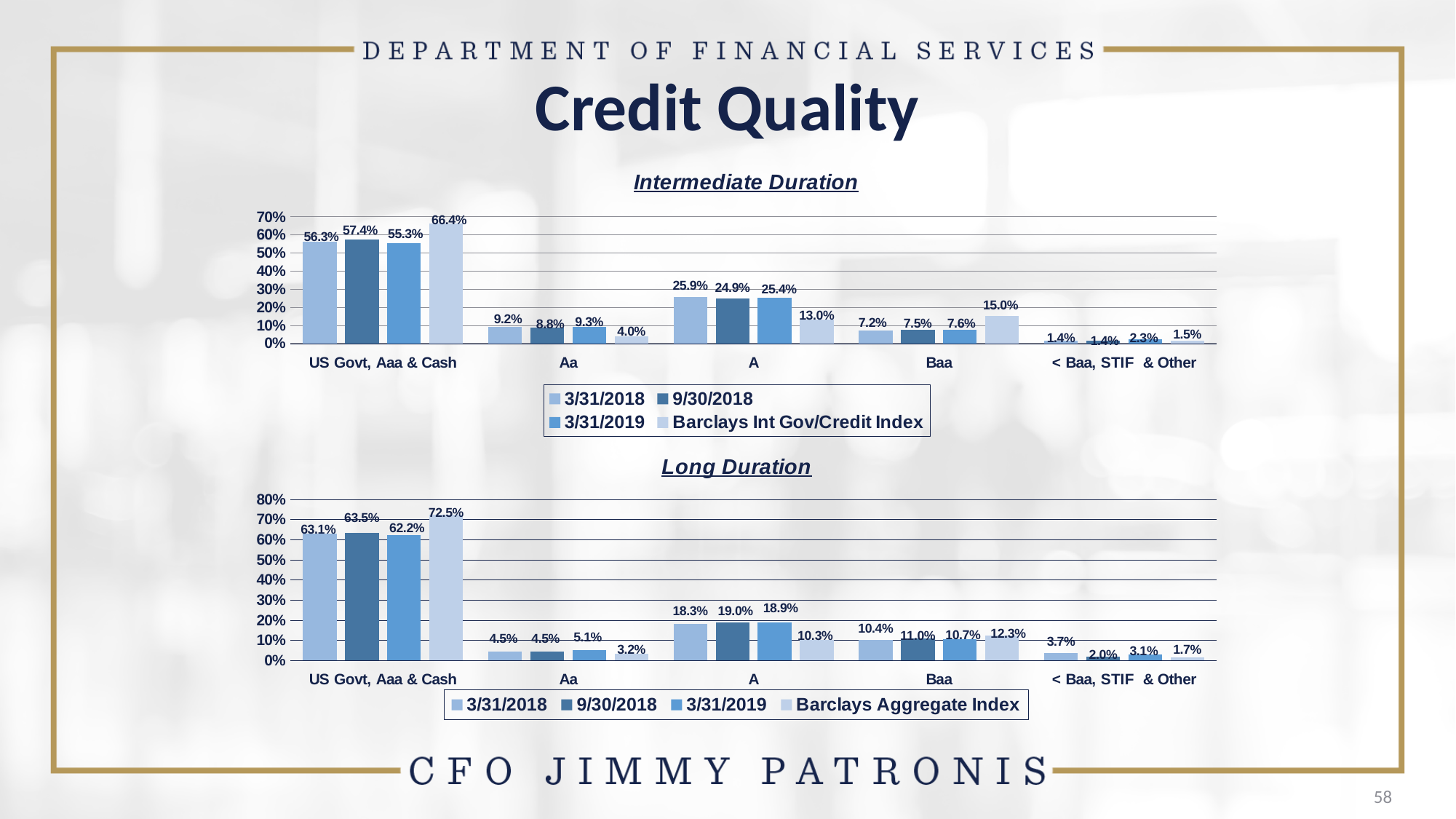
In the Intermediate Duration chart, what is the Barclays Int Gov/Credit Index value for Baa? 15.0% In the Intermediate Duration chart, what is the 3/31/2019 value for US Govt, Aaa & Cash? 55.3% In the Intermediate Duration chart, which category has the highest 3/31/2019 value? US Govt, Aaa & Cash What type of chart is the Long Duration chart? Bar chart In the Long Duration chart, what is the 3/31/2018 value for < Baa, STIF & Other? 3.7% In the Intermediate Duration chart, what is the difference between the Barclays Int Gov/Credit Index value and the 3/31/2019 value for US Govt, Aaa & Cash? 11.1% In the Long Duration chart, which is larger for Aa: the 3/31/2019 value or the Barclays Aggregate Index value? 3/31/2019 In the Long Duration chart, what is the name of the fourth series in the legend? Barclays Aggregate Index In the Long Duration chart, which category has the lowest Barclays Aggregate Index value? < Baa, STIF & Other How many series does the legend of the Intermediate Duration chart list? 4 In the Long Duration chart, what is the 9/30/2018 value for A? 19.0% How many categories are shown on the x axis of the Long Duration chart? 5